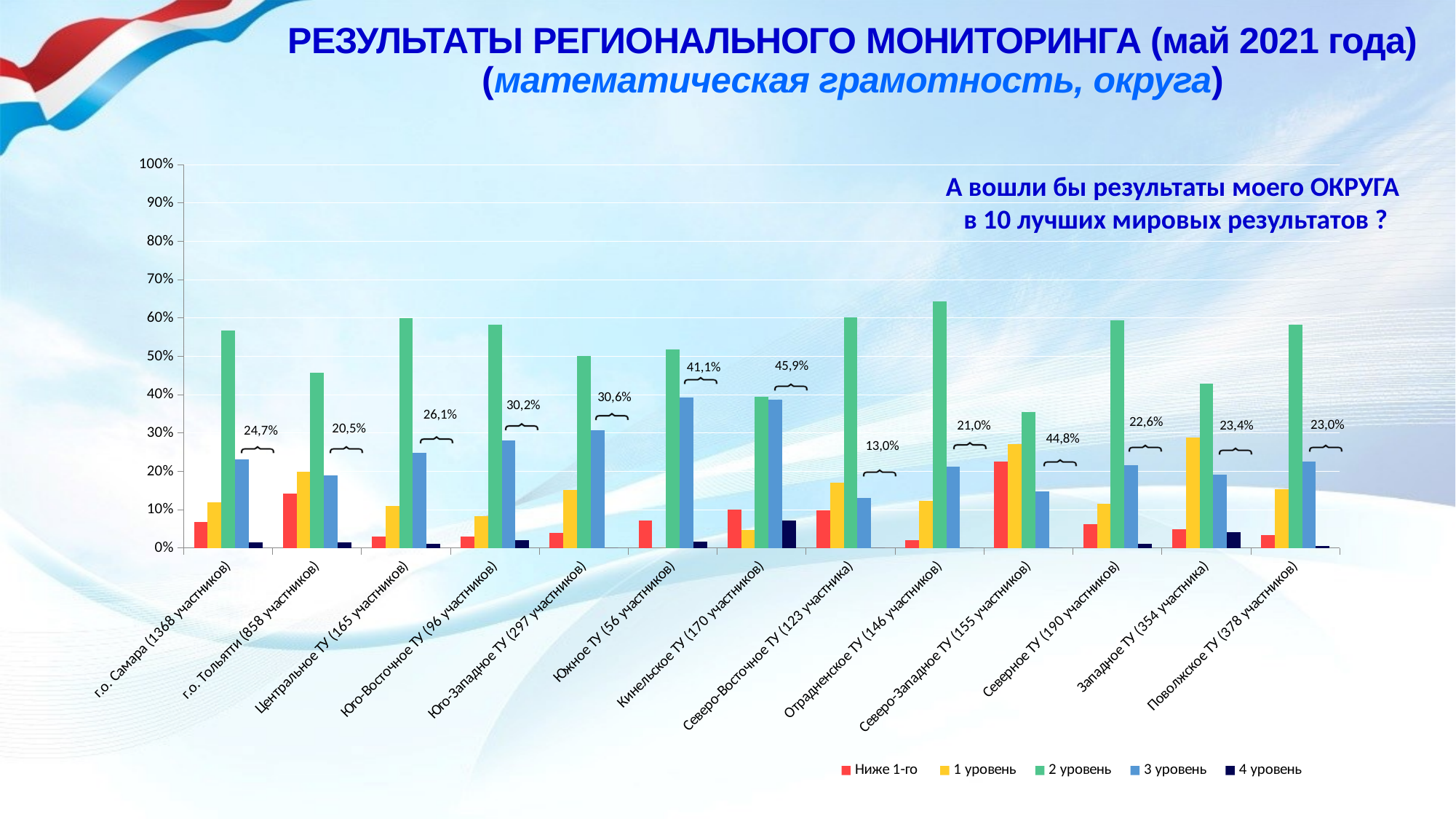
Which series is shown in green in the legend? 2 уровень Is the "3 уровень" value for Северо-Восточное ТУ greater or less than 20%? less Which district has the highest "Ниже 1-го" bar? Северо-Западное ТУ (155 участников) Which district has the highest "2 уровень" bar? Отрадненское ТУ (146 участников) How many districts (categories) are shown on the x axis? 13 Is the "Ниже 1-го" value for Северо-Западное ТУ greater or less than 20%? greater Which district has the lowest "2 уровень" bar? Северо-Западное ТУ (155 участников) Which is larger, the "Ниже 1-го" value for г.о. Тольятти or for г.о. Самара? г.о. Тольятти Which district has the highest "4 уровень" bar? Кинельское ТУ (170 участников) What kind of chart is shown on the slide? bar chart How many series does the legend list? 5 Is the "2 уровень" value for г.о. Самара greater or less than 50%? greater